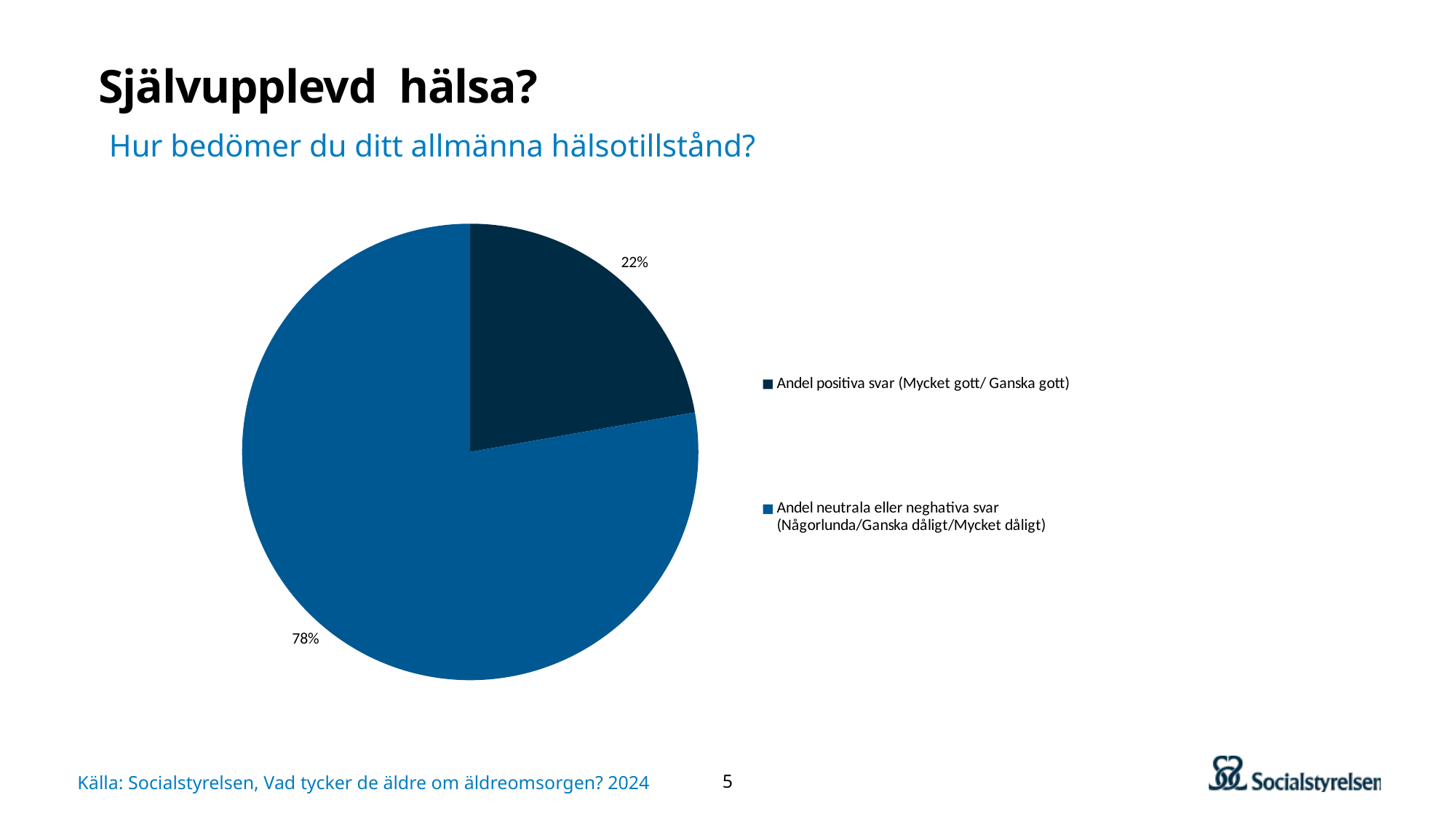
Which slice of the pie is the smallest? Andel positiva svar (Mycket gott/ Ganska gott) Which slice of the pie is the largest? Andel neutrala eller neghativa svar (Någorlunda/Ganska dåligt/Mycket dåligt) What is the difference in percentage points between the neutral/negative slice and the positive slice? 56 What kind of chart is shown on the slide? pie chart How many slices does the pie chart have? 2 How many entries does the legend list? 2 What share of the pie is 'Andel neutrala eller neghativa svar (Någorlunda/Ganska dåligt/Mycket dåligt)'? 78% Which is larger: the share of positive answers or the share of neutral/negative answers? Andel neutrala eller neghativa svar What question is the pie chart answering, as shown in the subtitle? Hur bedömer du ditt allmänna hälsotillstånd? Which legend entry is shown in the darker navy colour? Andel positiva svar (Mycket gott/ Ganska gott) What share of the pie is 'Andel positiva svar (Mycket gott/ Ganska gott)'? 22%